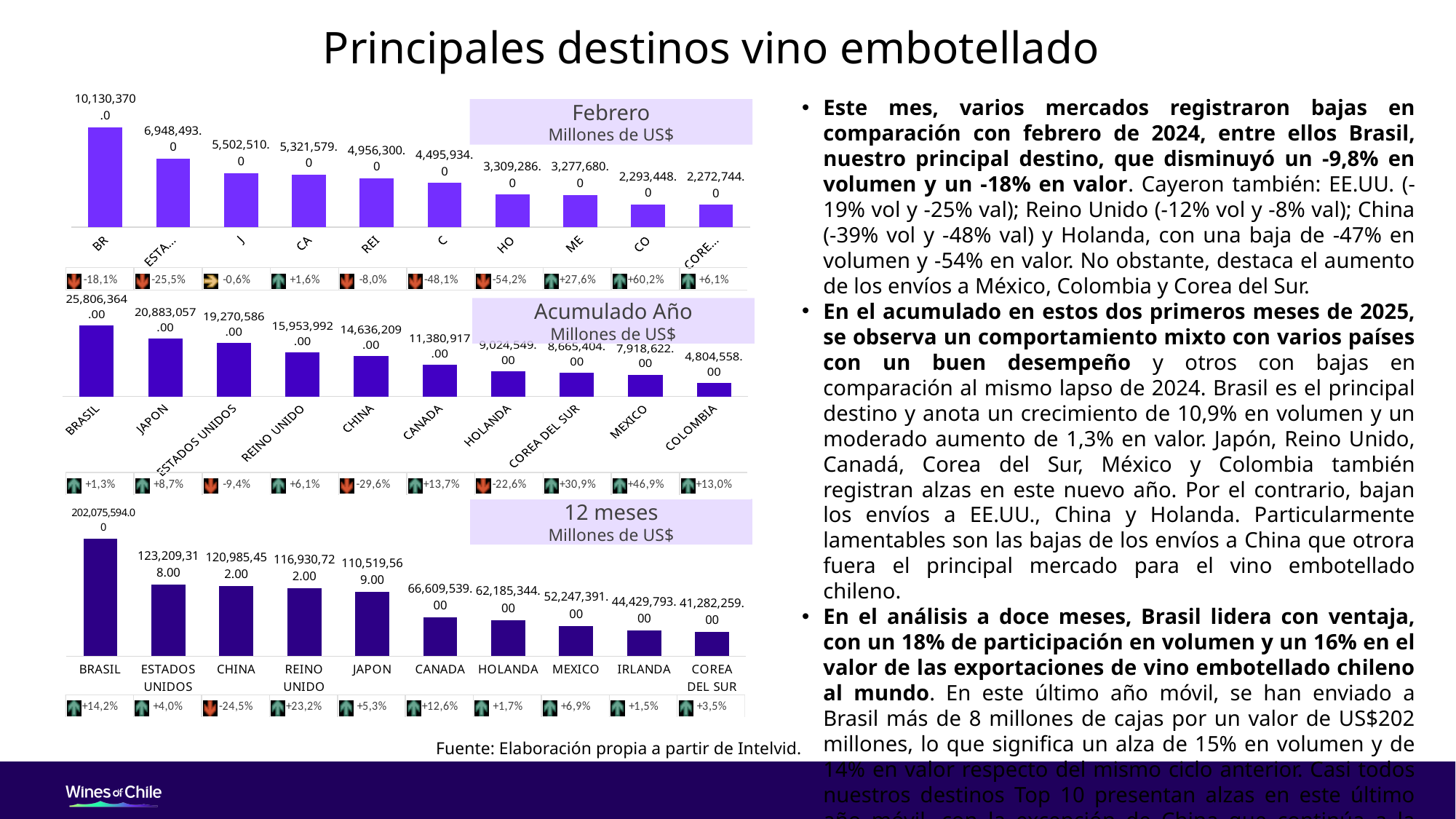
What kind of chart is the 'Febrero' chart? Bar chart In the '12 meses' chart, which country has the highest value? BRASIL In the '12 meses' chart, what is the difference between the values for BRASIL and ESTADOS UNIDOS? 78,866,276.00 In the '12 meses' chart, what is the value for CHINA? 120,985,452.00 In the 'Acumulado Año' chart, what is the value for BRASIL? 25,806,364.00 How many countries are shown in the '12 meses' chart? 10 In the 'Acumulado Año' chart, what is the value for COLOMBIA? 4,804,558.00 In the 'Acumulado Año' chart, do the values rise or fall from left to right? Fall In the 'Acumulado Año' chart, which country has the lowest value? COLOMBIA In the 'Acumulado Año' chart, what is the difference between the values for BRASIL and JAPON? 4,923,307.00 What unit is stated under the title of the '12 meses' chart? Millones de US$ In the '12 meses' chart, which is larger, the value for CANADA or the value for MEXICO? CANADA